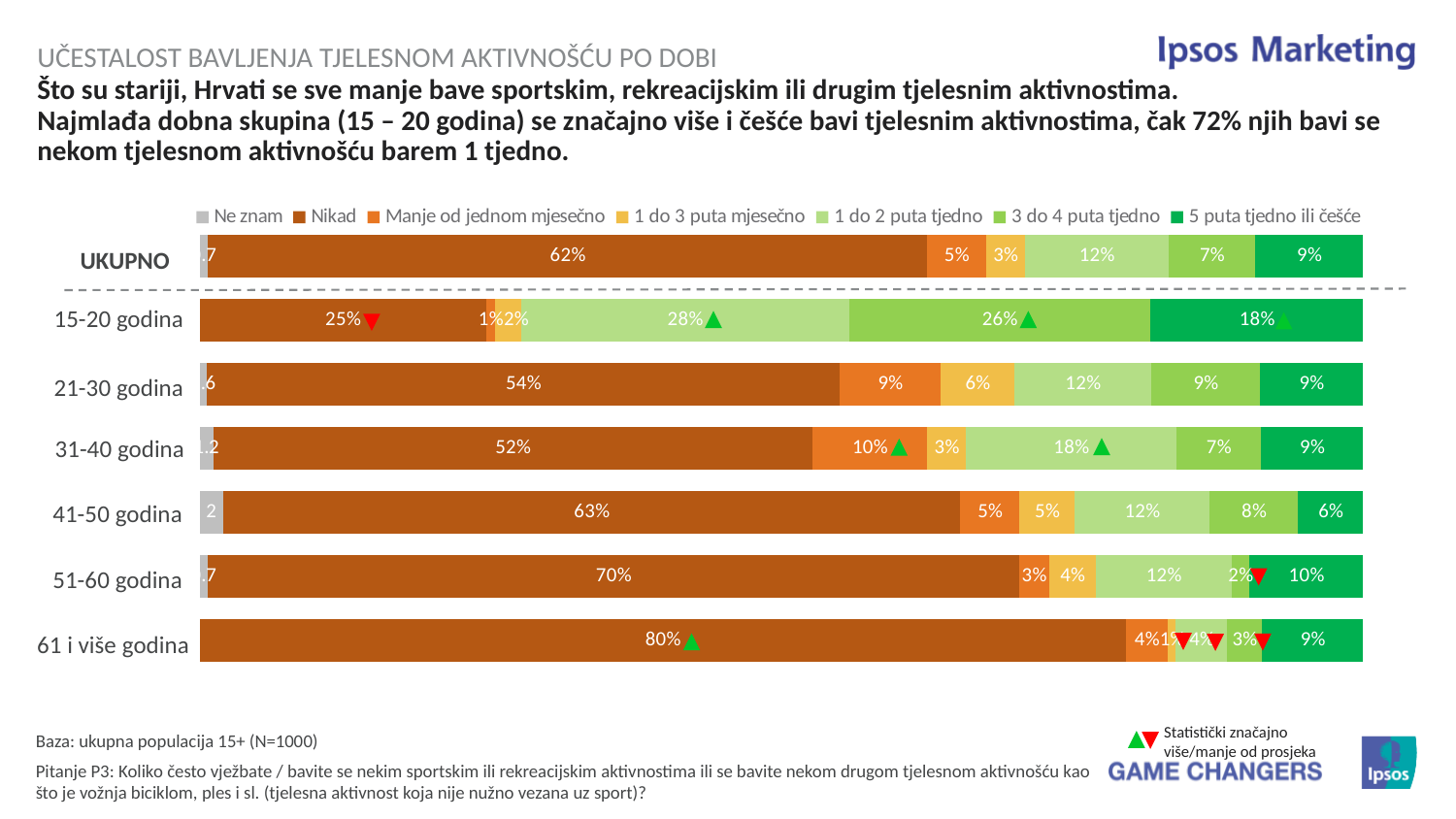
Which age group has the lowest 'Nikad' value? 15-20 godina What type of chart is shown on the slide? stacked bar chart What is the '1 do 2 puta tjedno' value for the 31-40 godina group? 18% What is the '5 puta tjedno ili češće' value for the 15-20 godina group? 18% What is the 'Nikad' value for the 61 i više godina group? 80% What is the 'Nikad' value for the 15-20 godina group? 25% Does the 'Nikad' value generally rise or fall as the age groups get older (from 15-20 to 61 i više godina)? rise Which is larger: the '3 do 4 puta tjedno' value for 15-20 godina or for 21-30 godina? 15-20 godina How many series does the legend list? 7 Which age group has the highest 'Nikad' value? 61 i više godina What is the difference between the 'Nikad' values for 51-60 godina and 21-30 godina? 16% How many age groups (including UKUPNO) are plotted on the chart? 7